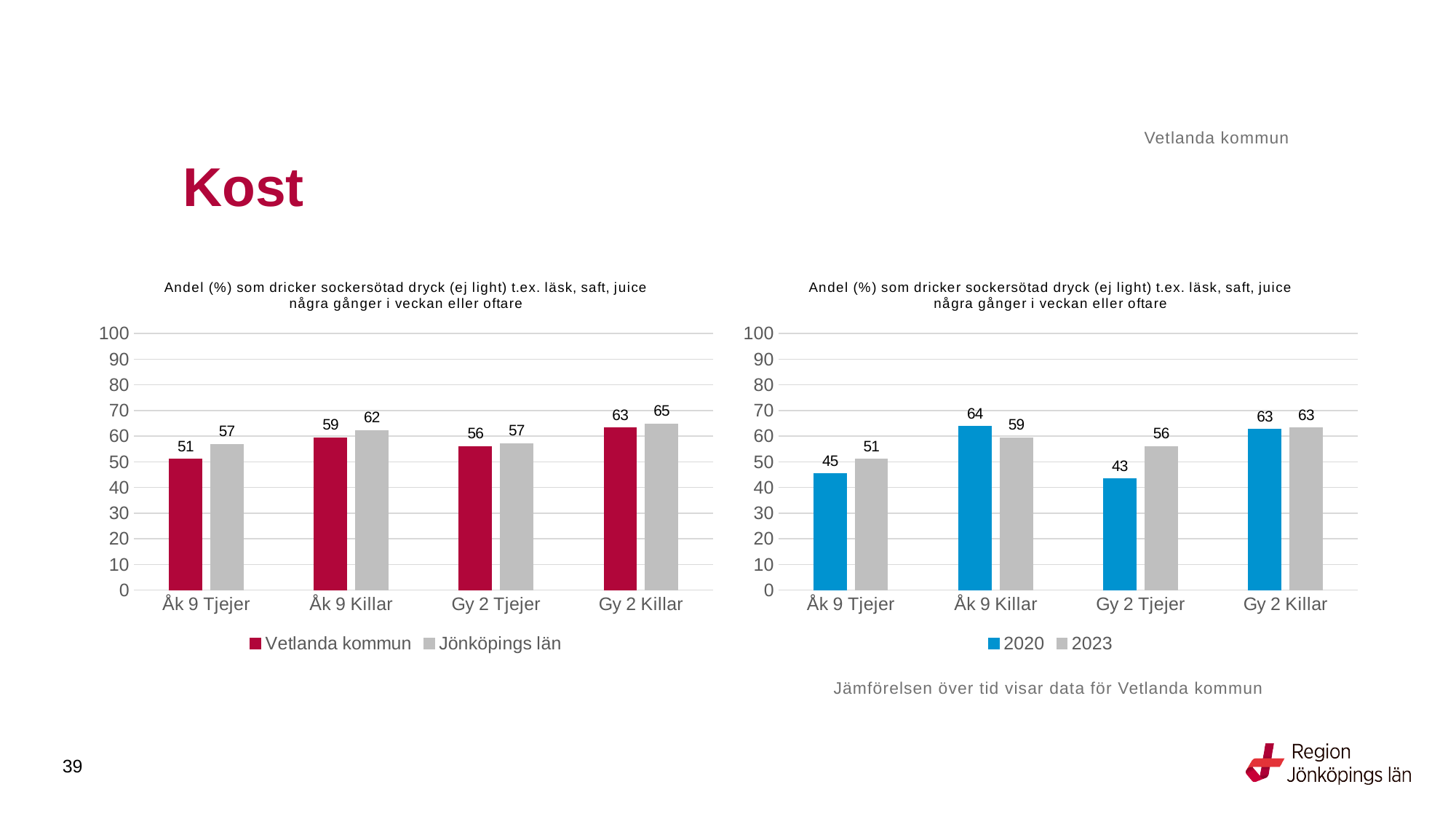
In the left chart, what is the value for Jönköpings län for Gy 2 Killar? 65 In the right chart, what is the value for 2020 for Gy 2 Tjejer? 43 In the left chart, what is the value for Vetlanda kommun for Åk 9 Tjejer? 51 In the right chart, what is the value for 2023 for Åk 9 Killar? 59 In the left chart, which category has the highest value for Vetlanda kommun? Gy 2 Killar In the left chart, how many series does the legend list? 2 In the right chart, what is the difference between 2023 and 2020 for Gy 2 Tjejer? 13 What kind of chart is the right chart? Bar chart In the right chart, which is larger for Åk 9 Killar, 2020 or 2023? 2020 In the right chart, which category has the lowest value for 2020? Gy 2 Tjejer In the left chart, what is the difference between Jönköpings län and Vetlanda kommun for Åk 9 Tjejer? 6